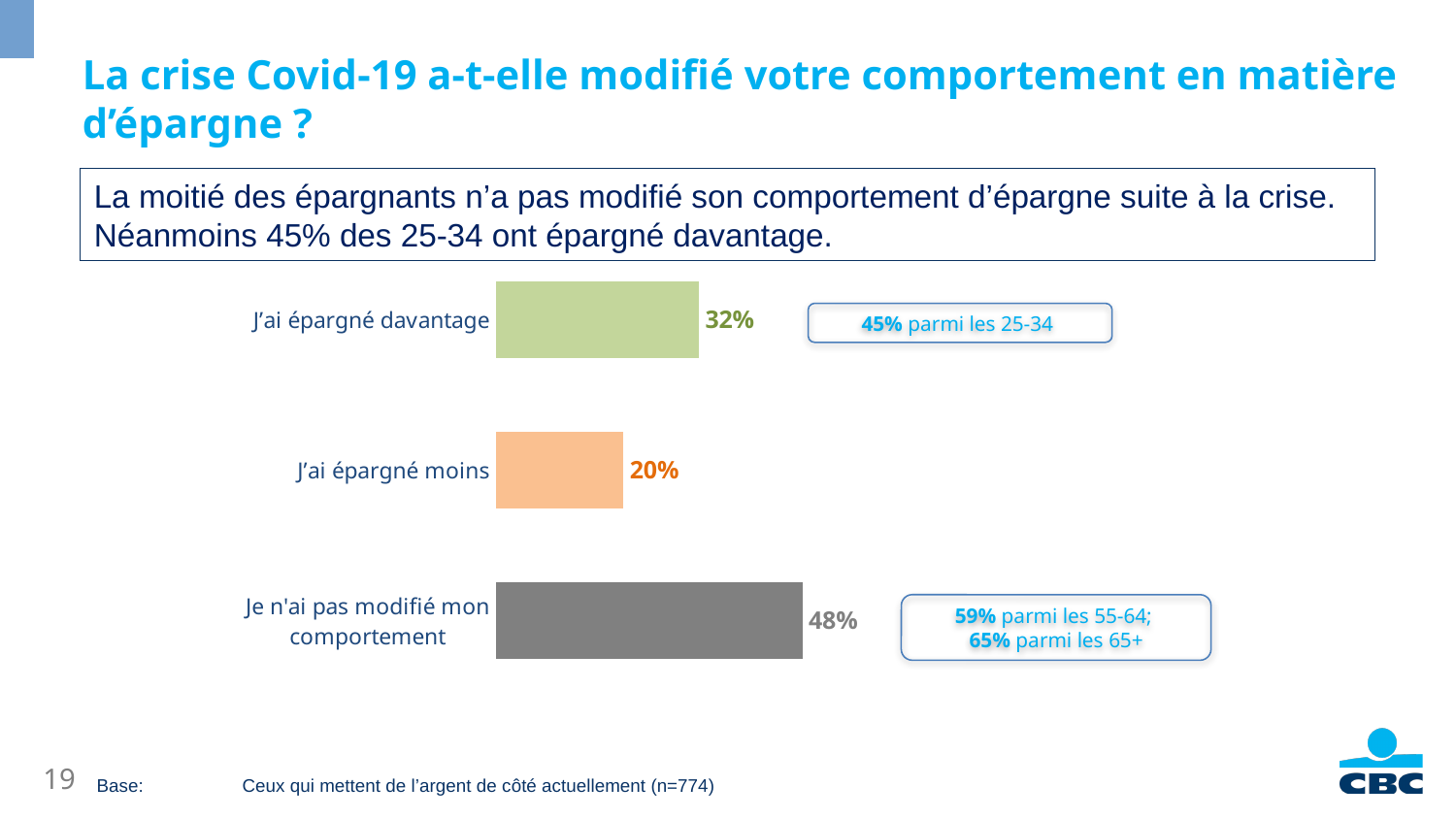
Which category has the highest value? Je n'ai pas modifié mon comportement What is the difference between "Je n'ai pas modifié mon comportement" and "J'ai épargné davantage"? 16% Which category has the lowest value? J'ai épargné moins According to the callout next to "Je n'ai pas modifié mon comportement", what share of the 65+ age group did not change their behaviour? 65% According to the callout next to "J'ai épargné davantage", what share of the 25-34 age group saved more? 45% What is the value for "J'ai épargné davantage"? 32% What is the value for "Je n'ai pas modifié mon comportement"? 48% What is the value for "J'ai épargné moins"? 20% Which is larger, "J'ai épargné davantage" or "J'ai épargné moins"? J'ai épargné davantage What is the difference between "J'ai épargné davantage" and "J'ai épargné moins"? 12% What kind of chart is shown on the slide? Bar chart How many categories are shown in the chart? 3